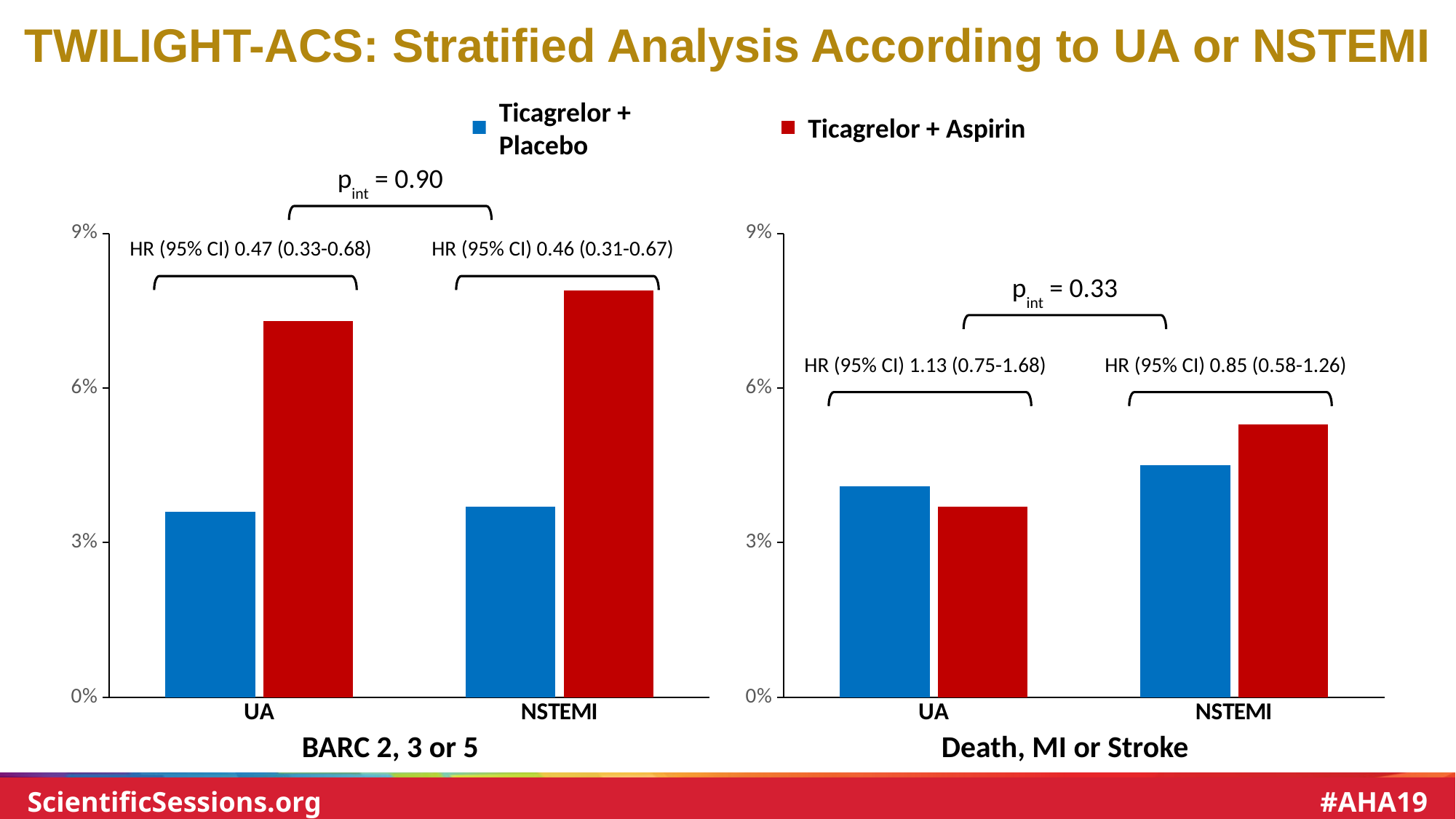
How many series does the legend list? 2 In the 'Death, MI or Stroke' chart, which bar is the lowest? Ticagrelor + Aspirin, UA How many categories are shown on the x axis of the 'Death, MI or Stroke' chart? 2 In the 'Death, MI or Stroke' chart, which is larger for the UA group: Ticagrelor + Placebo or Ticagrelor + Aspirin? Ticagrelor + Placebo In the 'Death, MI or Stroke' chart, is the value for Ticagrelor + Placebo in the UA group greater or less than 3%? greater In the 'Death, MI or Stroke' chart, which is larger for the NSTEMI group: Ticagrelor + Placebo or Ticagrelor + Aspirin? Ticagrelor + Aspirin What kind of chart is the 'BARC 2, 3 or 5' chart? bar chart What is the HR (95% CI) shown for the UA group in the 'BARC 2, 3 or 5' chart? 0.47 (0.33-0.68) In the 'BARC 2, 3 or 5' chart, which bar is the highest? Ticagrelor + Aspirin, NSTEMI In the 'BARC 2, 3 or 5' chart, is the value for Ticagrelor + Placebo in the NSTEMI group greater or less than 6%? less In the 'Death, MI or Stroke' chart, is the value for Ticagrelor + Aspirin in the NSTEMI group greater or less than 6%? less